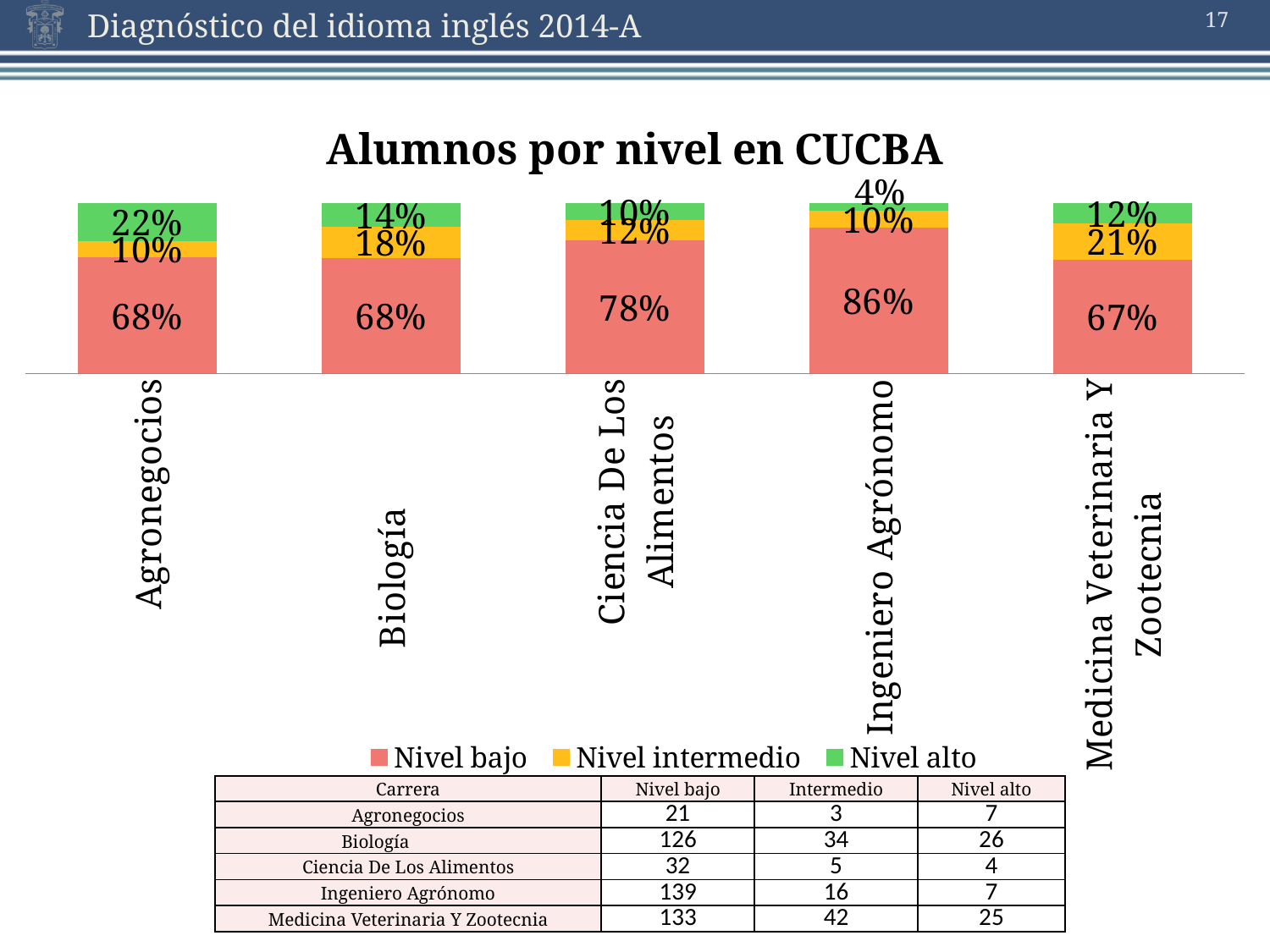
What is the difference between the Nivel bajo percentages of Ingeniero Agrónomo and Medicina Veterinaria Y Zootecnia? 19% Which is larger, the Nivel intermedio percentage for Biología or for Agronegocios? Biología What kind of chart is shown on the slide? stacked bar chart What is the Nivel bajo percentage for Ciencia De Los Alimentos? 78% Which career has the lowest Nivel alto percentage? Ingeniero Agrónomo How many careers (categories) are plotted in the chart? 5 How many series does the chart legend list? 3 What is the Nivel alto percentage for Agronegocios? 22% What is the Nivel intermedio percentage for Medicina Veterinaria Y Zootecnia? 21% Which career has the highest Nivel bajo percentage? Ingeniero Agrónomo What is the title of the chart? Alumnos por nivel en CUCBA What is the Nivel bajo percentage for Ingeniero Agrónomo? 86%